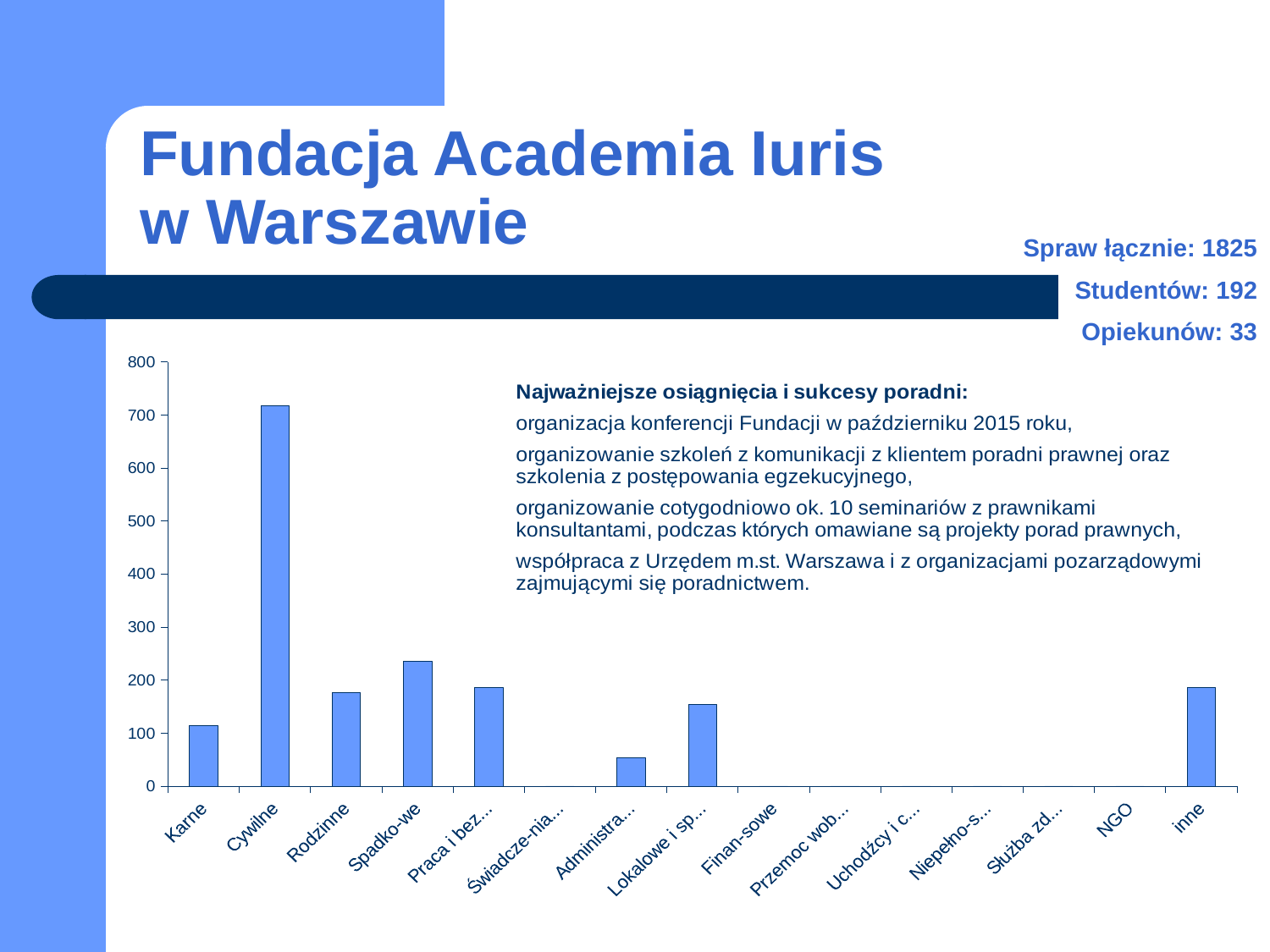
Which is larger, the value for Spadko-we or the value for Rodzinne? Spadko-we Is the value for Lokalowe i sp... greater or less than 100? greater Is the value for Karne greater or less than 100? greater How many categories are shown on the x axis of the chart? 15 Is the value for Spadko-we greater or less than 200? greater What kind of chart is shown on the slide? bar chart What is the highest value shown on the vertical axis of the chart? 800 Which category has the highest bar in the chart? Cywilne Which is larger, the value for Cywilne or the value for Karne? Cywilne